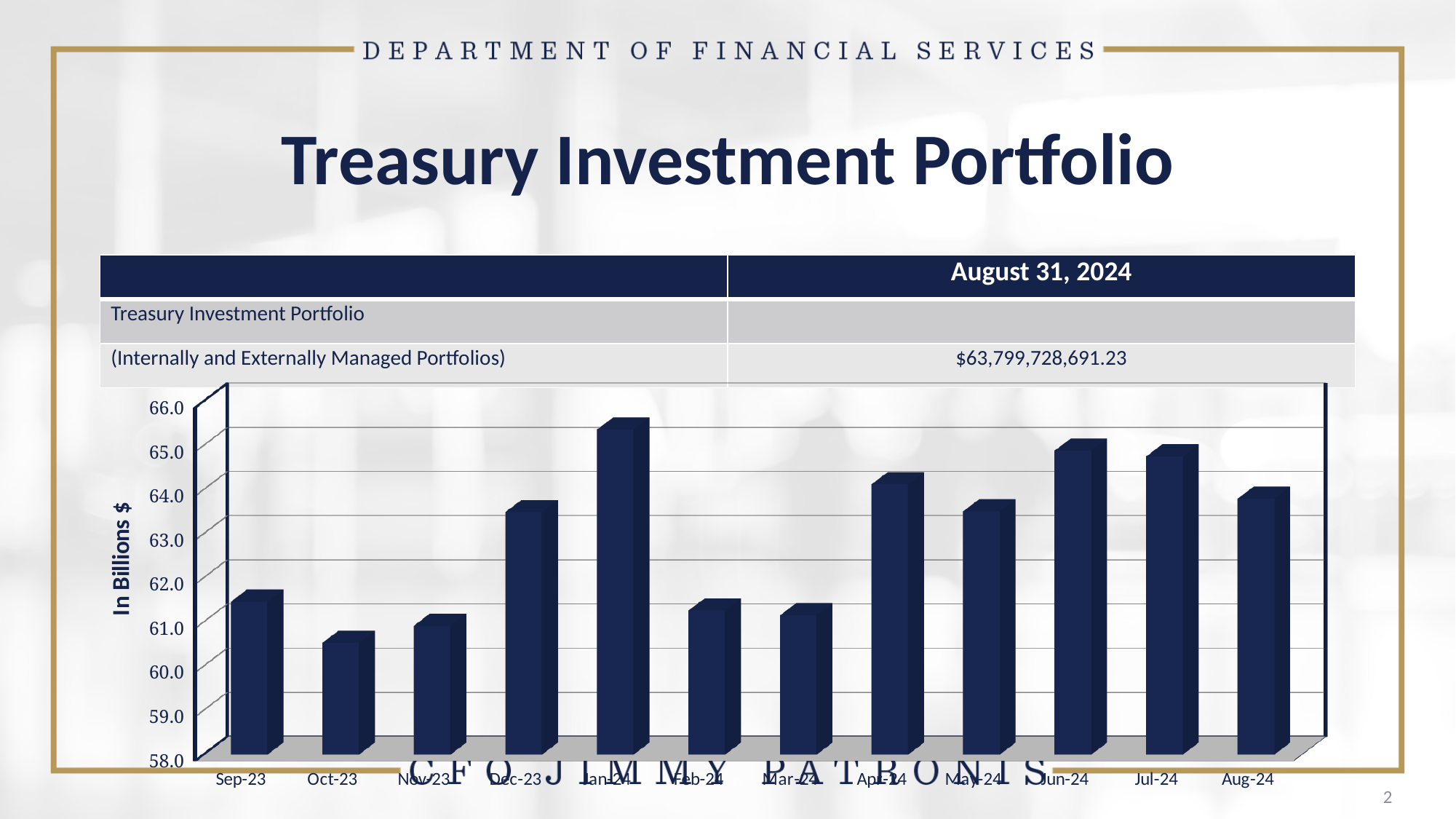
Which month has the lowest value on the chart? Oct-23 What kind of chart is shown on the slide? bar chart Is the value for Feb-24 greater or less than 62.0? less Which is larger, the value for Jun-24 or the value for Aug-24? Jun-24 Which is larger, the value for Dec-23 or the value for Nov-23? Dec-23 What is the title of the vertical axis of the chart? In Billions $ Is the value for Dec-23 greater or less than 63.0? greater Is the value for Oct-23 greater or less than 61.0? less Which month has the highest value on the chart? Jan-24 Do the values rise or fall from Jan-24 to Feb-24? fall How many months are plotted on the chart? 12